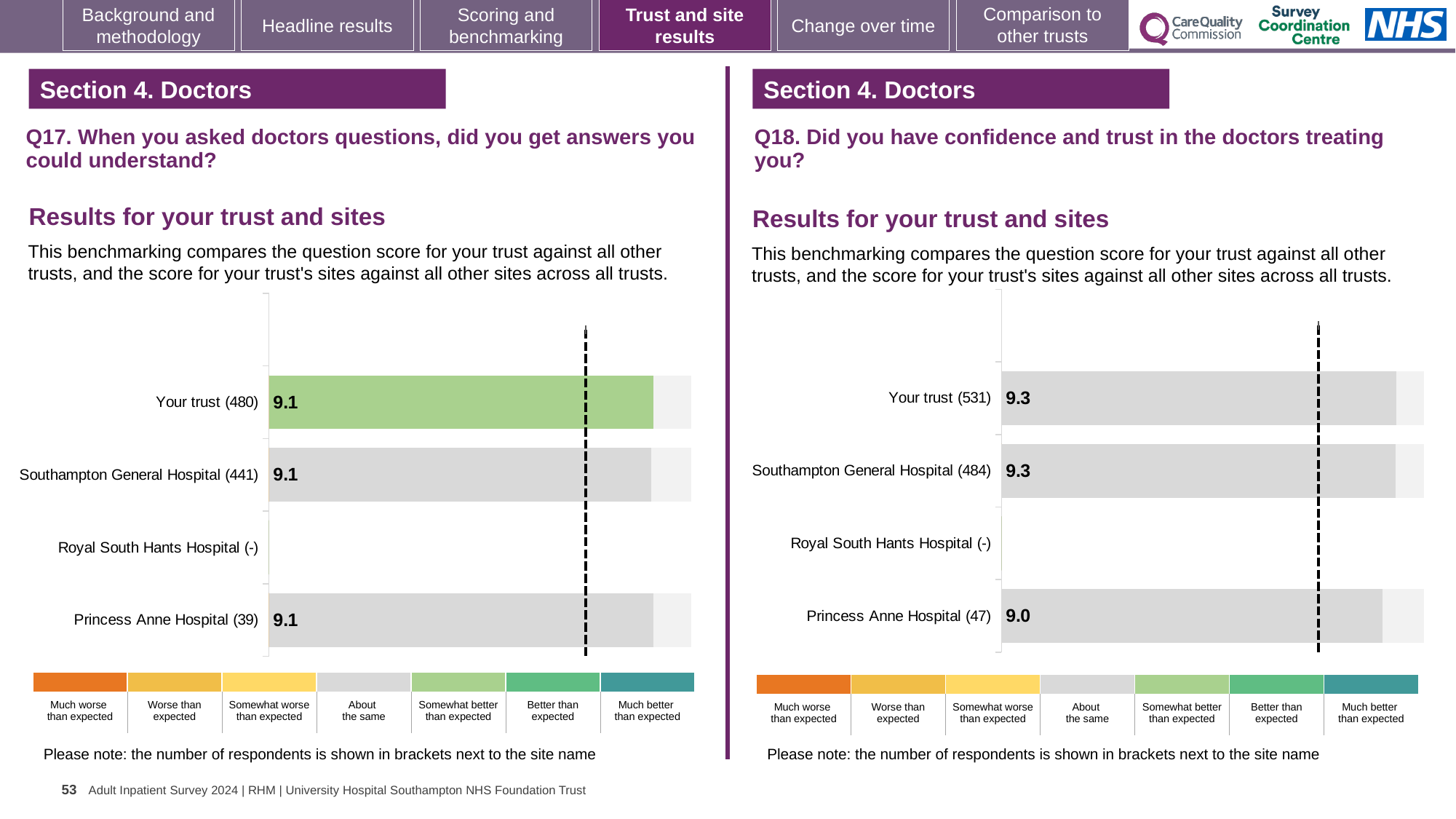
In the Q18 chart, what is the score for Princess Anne Hospital? 9.0 In the Q17 chart, what is the score for Princess Anne Hospital? 9.1 In the Q17 chart, what is the score for Your trust? 9.1 In the Q18 chart, what is the score for Southampton General Hospital? 9.3 In the Q18 chart, which is larger: the score for Southampton General Hospital or the score for Princess Anne Hospital? Southampton General Hospital What kind of chart is the Q18 chart? Bar chart In the Q17 chart, which benchmark category does the green colour of the Your trust bar correspond to? Somewhat better than expected In the Q18 chart, what is the score for Your trust? 9.3 How many sites or categories are listed on the y axis of the Q17 chart? 4 In the Q18 chart, which site with a plotted score has the lowest score? Princess Anne Hospital In the Q18 chart, what is the difference between the scores for Your trust and Princess Anne Hospital? 0.3 In the Q17 chart, how many respondents are shown in brackets for Your trust? 480